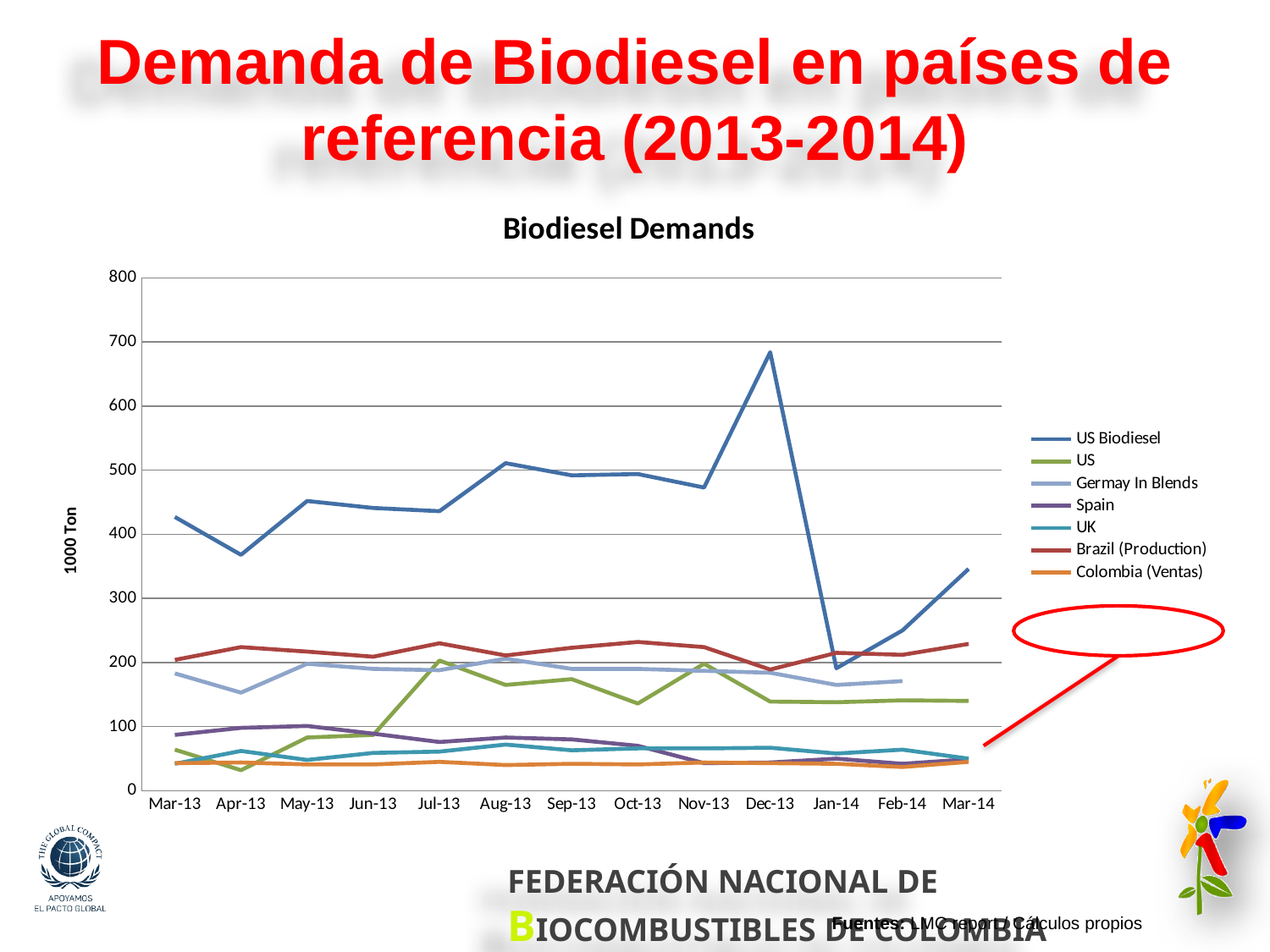
How many series does the legend of the Biodiesel Demands chart list? 7 What kind of chart is shown on the slide? line chart Does the US Biodiesel series rise or fall from Dec-13 to Jan-14? fall In which month does the US Biodiesel series reach its highest value? Dec-13 What is the label on the vertical axis of the chart? 1000 Ton Which series is higher in Mar-13, US Biodiesel or Brazil (Production)? US Biodiesel Is the value for US Biodiesel in Dec-13 greater or less than 600? greater In which month does the US Biodiesel series reach its lowest value? Jan-14 Is the value for US Biodiesel in Jan-14 greater or less than 300? less Is the value for Brazil (Production) in Mar-13 greater or less than 300? less How many months are plotted along the x axis of the Biodiesel Demands chart? 13